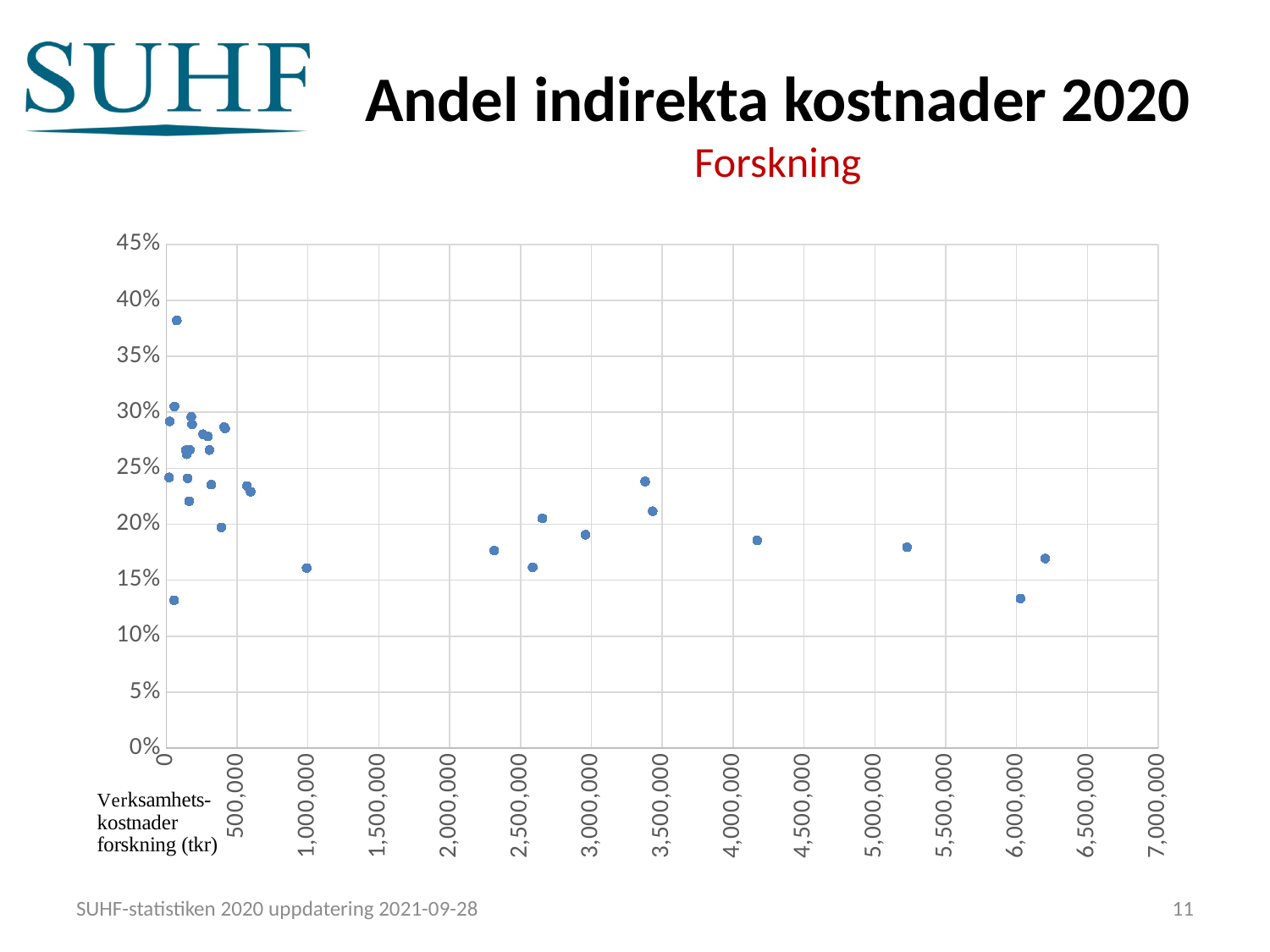
Which has the larger value: the higher point plotted near 3,400,000 on the x axis or the point plotted near 6,000,000 on the x axis? the point near 3,400,000 Is the highest plotted point in the chart greater or less than 35%? greater What is the highest value shown on the vertical axis of the chart? 45% What kind of chart is shown on the slide? scatter chart Is the value of the point plotted near 6,000,000 on the x axis greater or less than 15%? less What is the title of the chart on the slide? Andel indirekta kostnader 2020 What is the highest value shown on the horizontal axis of the chart? 7,000,000 Do the plotted values generally rise or fall as the horizontal axis value increases? fall Is the value of the point plotted near 1,000,000 on the x axis greater or less than 20%? less What is the label of the horizontal axis of the chart? Verksamhetskostnader forskning (tkr)